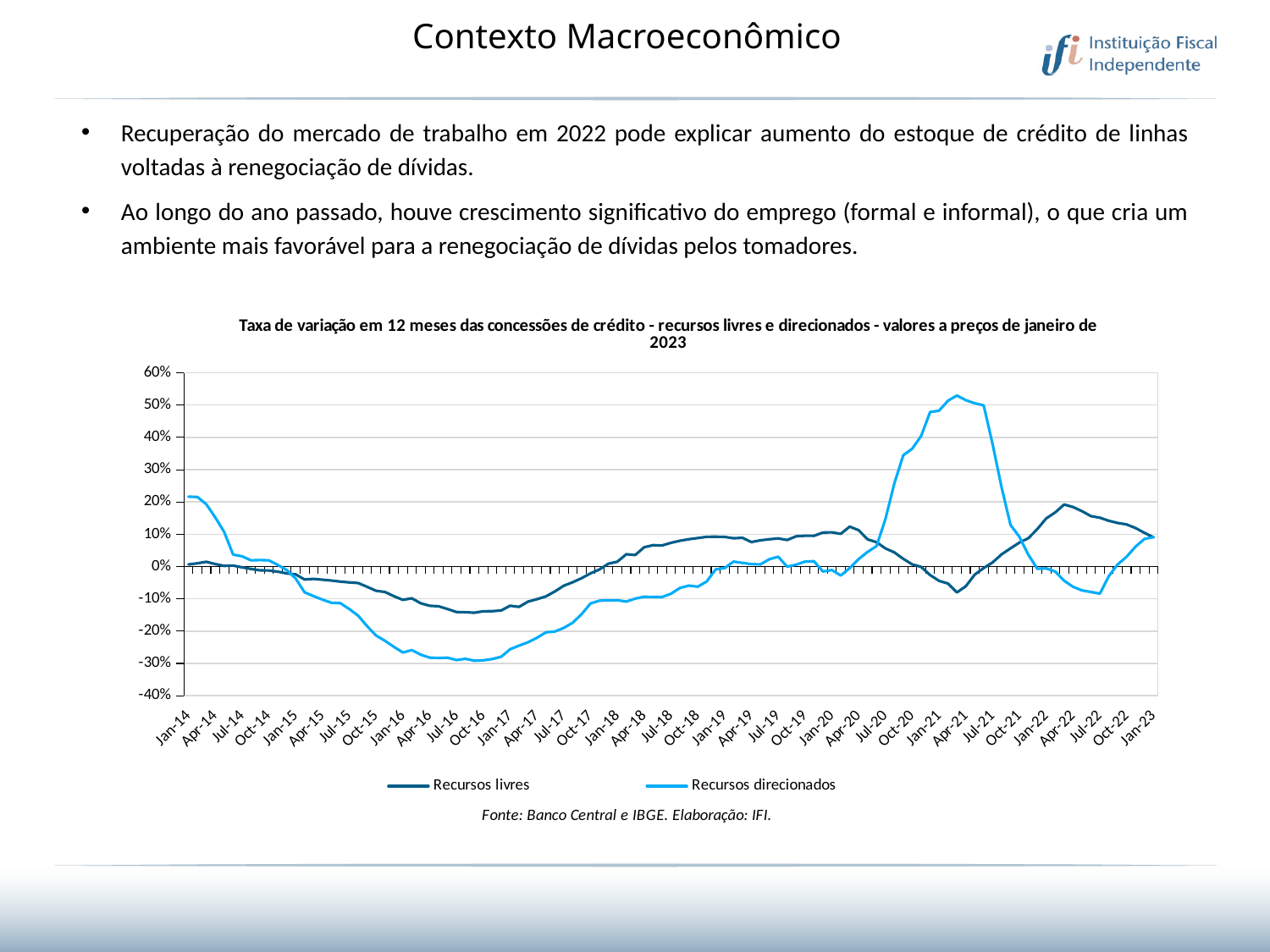
At Apr-21, which series has the higher value, Recursos livres or Recursos direcionados? Recursos direcionados Is the value for Recursos direcionados at Jan-14 greater or less than 10%? greater Which series reaches the highest value anywhere on the chart? Recursos direcionados At Jul-16, which series has the higher value, Recursos livres or Recursos direcionados? Recursos livres Is the value for Recursos livres at Apr-21 greater or less than 0%? less Is the value for Recursos direcionados at Jul-16 greater or less than -20%? less According to the note below the chart, what is the source of the data? Banco Central e IBGE. Elaboração: IFI. What are the two series named in the chart legend? Recursos livres and Recursos direcionados What kind of chart is shown on the slide? Line chart Does the Recursos direcionados series rise or fall between Jan-14 and Jul-16? Fall How many series does the chart legend list? 2